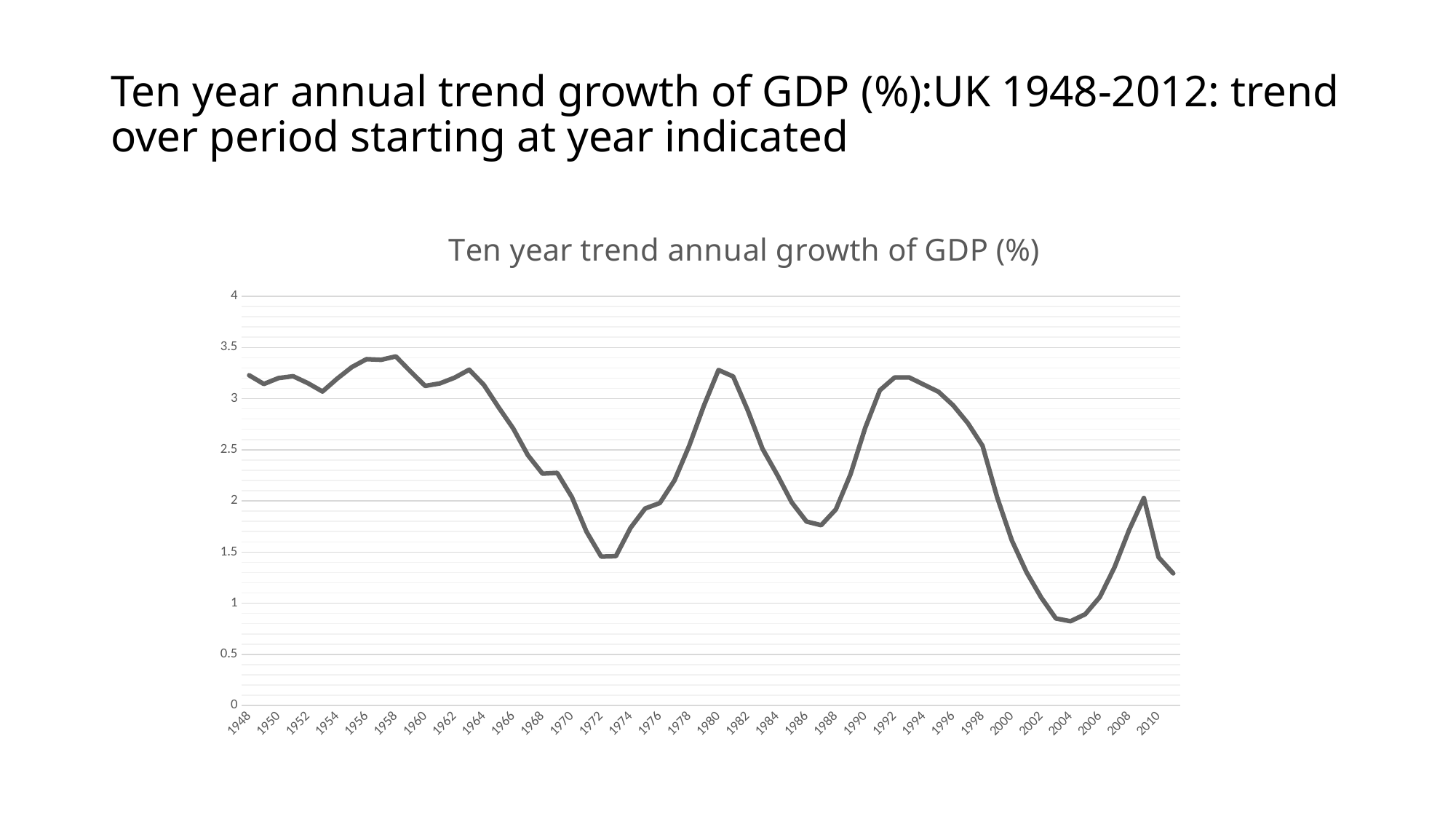
What kind of chart is shown on the slide? line chart Is the value for 1986 greater or less than 2? less Which year has the larger value, 1972 or 1992? 1992 What is the highest value shown on the vertical axis? 4 Do the values rise or fall between 1992 and 2004? fall Which year has the larger value, 1980 or 2004? 1980 Is the value for 1980 greater or less than 3? greater What is the title printed above the chart? Ten year trend annual growth of GDP (%) Is the value for 1972 greater or less than 2? less